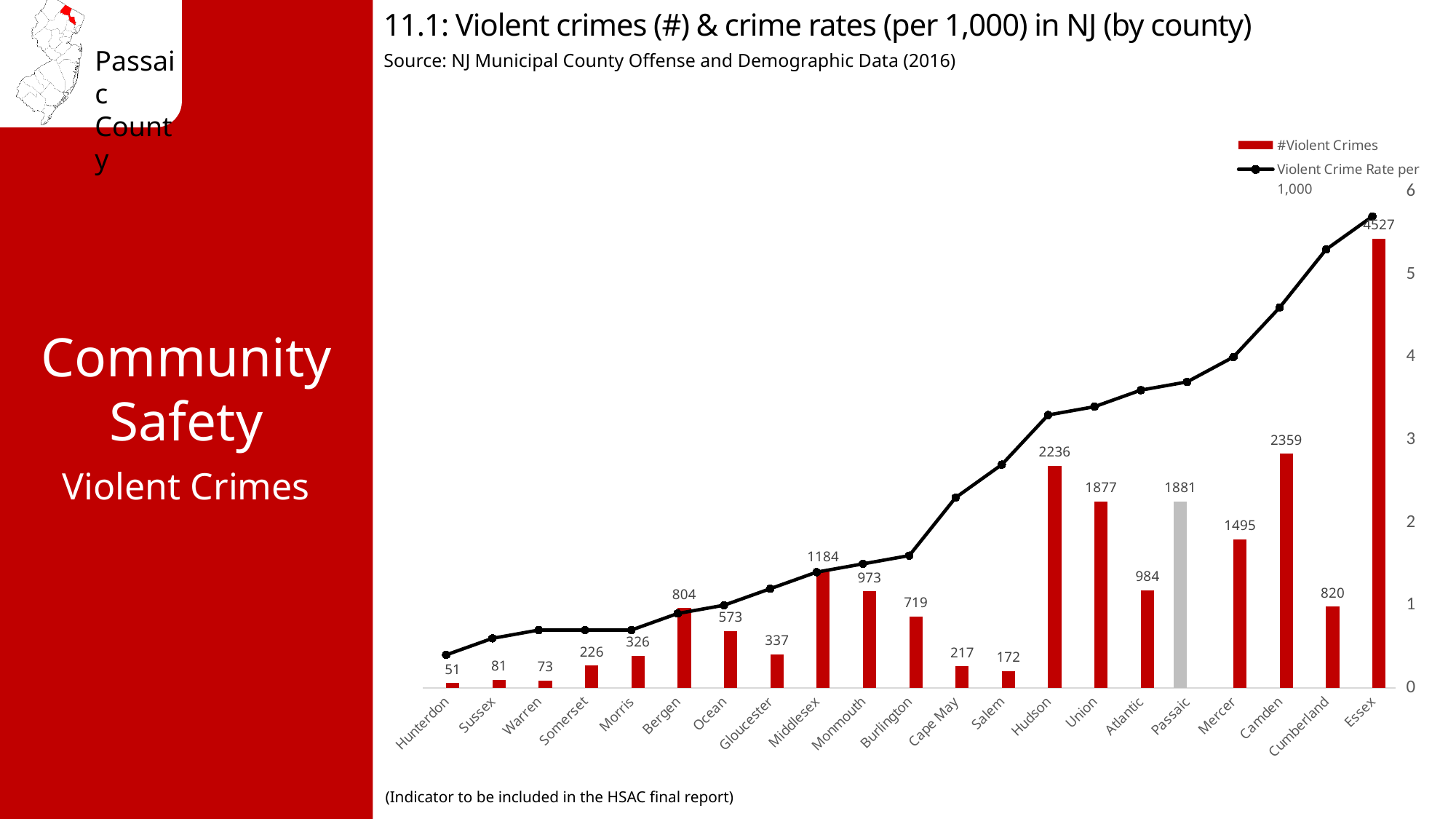
How many violent crimes are shown for Hudson? 2236 Which county has the lowest number of violent crimes? Hunterdon Is the violent crime rate per 1,000 for Essex greater or less than 5? greater Which county has the highest number of violent crimes? Essex How many series does the legend list? 2 How many violent crimes are shown for Passaic? 1881 Is the violent crime rate per 1,000 for Hunterdon greater or less than 1? less Does the violent crime rate per 1,000 line generally rise or fall from Hunterdon to Essex? rise What is the difference in the number of violent crimes between Essex and Camden? 2168 How many counties are shown on the x axis? 21 Which county's bar is coloured grey instead of red? Passaic Which county has more violent crimes, Union or Mercer? Union